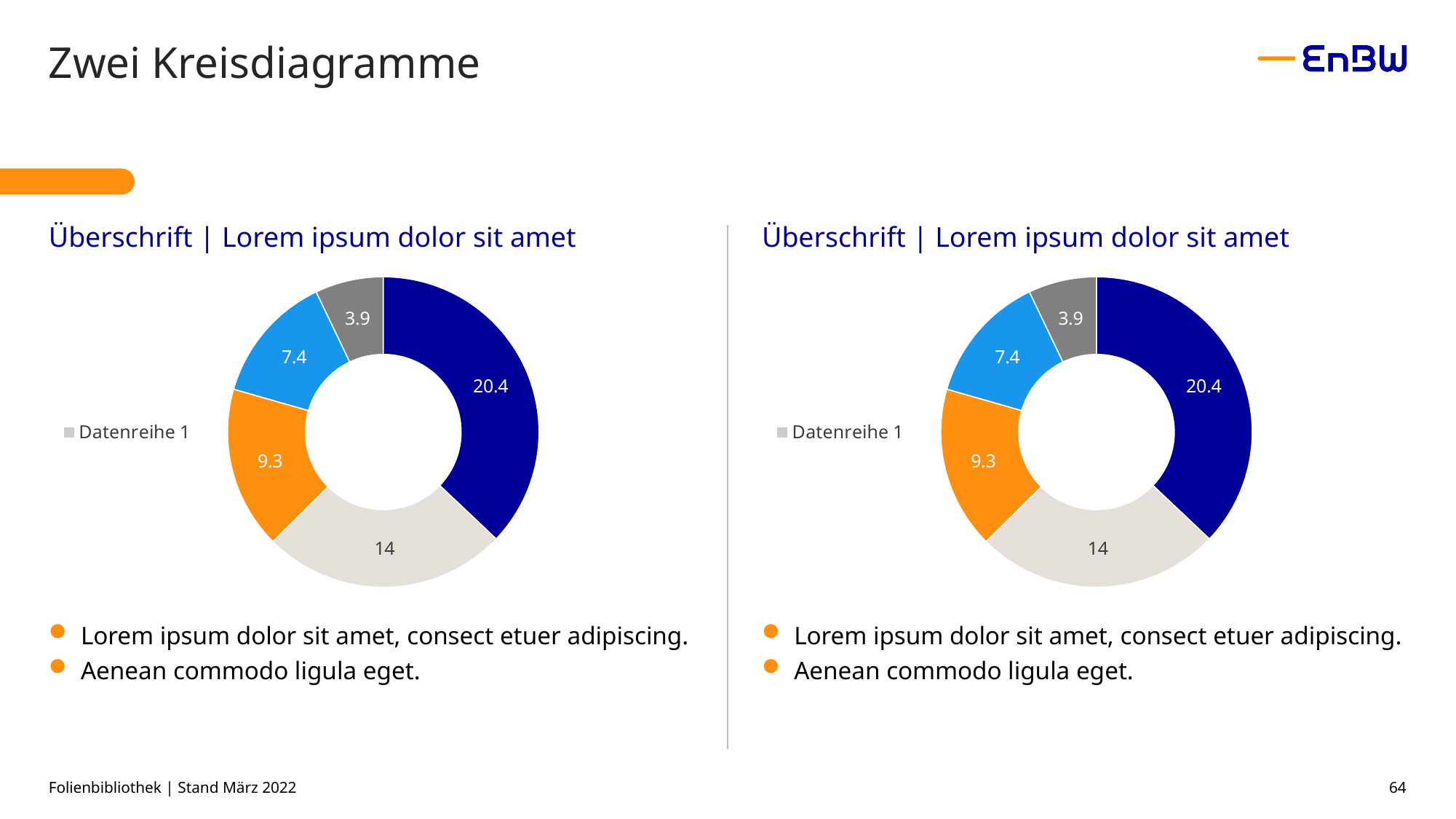
What is the legend entry shown next to the left chart? Datenreihe 1 In the left chart, what is the difference between the dark blue slice and the light grey slice? 6.4 In the right chart, which slice has the largest value? The dark blue slice (20.4) In the left chart, what is the value of the dark blue slice? 20.4 How many slices does the left chart have? 5 In the right chart, what is the value of the light blue slice? 7.4 In the left chart, what is the value of the light grey slice? 14 What is the total of all slice values in the right chart? 55 In the left chart, which slice has the smallest value? The dark grey slice (3.9) What kind of chart is the left chart on the slide? Doughnut (pie) chart In the right chart, what is the value of the orange slice? 9.3 In the right chart, which is larger: the orange slice or the light blue slice? The orange slice (9.3)